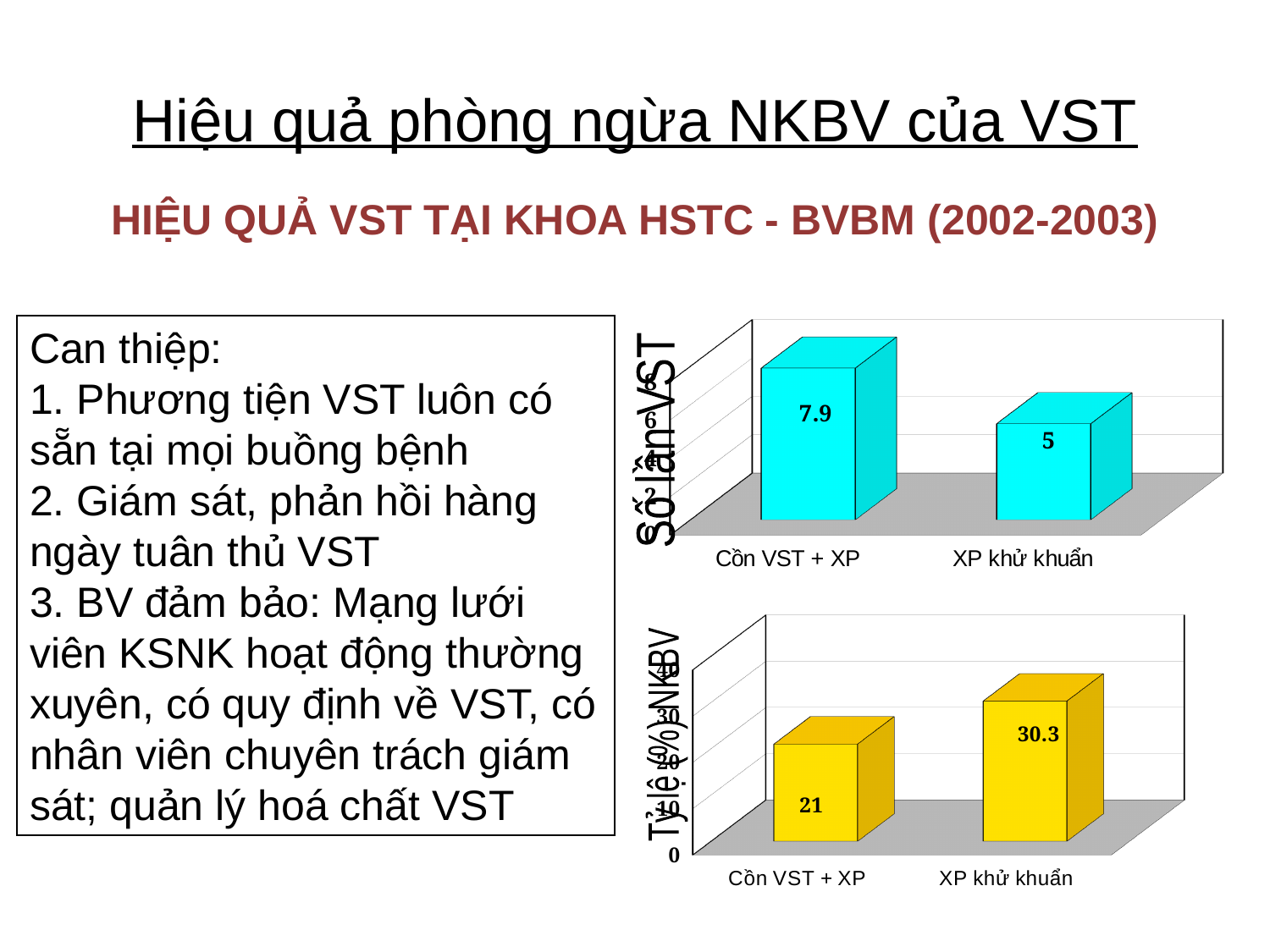
In the bottom chart, what is the value for XP khử khuẩn? 30.3 In the top chart, what is the value for XP khử khuẩn? 5 What type of chart is the bottom chart? bar chart In the bottom chart, is the value for XP khử khuẩn larger or smaller than the value for Cồn VST + XP? larger In the bottom chart, what is the difference between the values for XP khử khuẩn and Cồn VST + XP? 9.3 In the bottom chart, what is the value for Cồn VST + XP? 21 In the top chart, which category has the higher value? Cồn VST + XP In the top chart, what is the difference between the values for Cồn VST + XP and XP khử khuẩn? 2.9 How many categories are shown in the top chart? 2 In the top chart, what is the value for Cồn VST + XP? 7.9 What colour are the bars in the top chart? cyan In the bottom chart, which category has the lower value? Cồn VST + XP